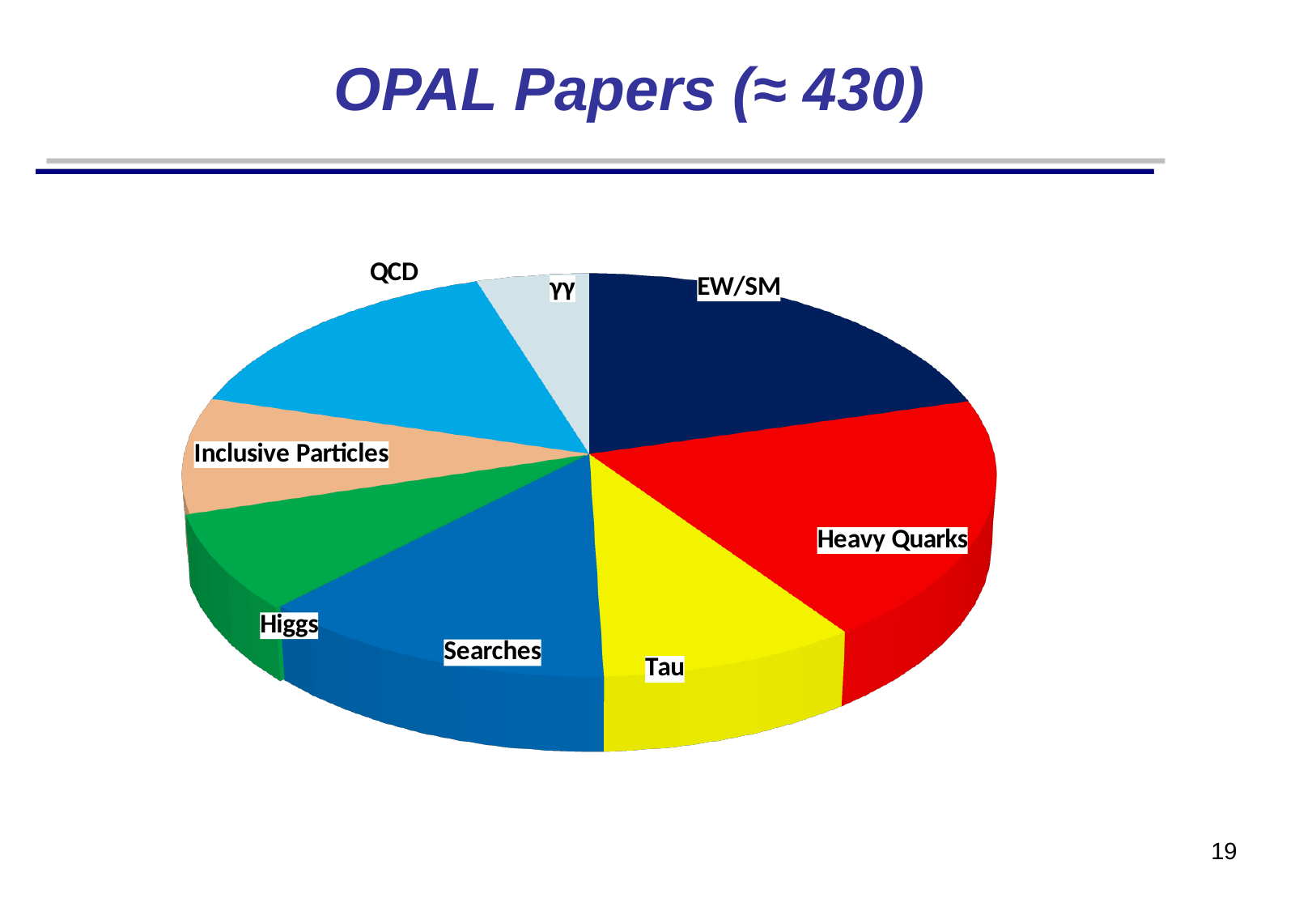
Which slice is larger, Searches or Higgs? Searches Which slice is larger, Tau or γγ? Tau What kind of chart is shown on the slide? pie chart Which slice is larger, QCD or Inclusive Particles? QCD What is the title of the slide containing the pie chart? OPAL Papers (≈ 430) How many slices does the pie chart have? 8 What colour is the Heavy Quarks slice? red Which category has the smallest slice of the pie? γγ